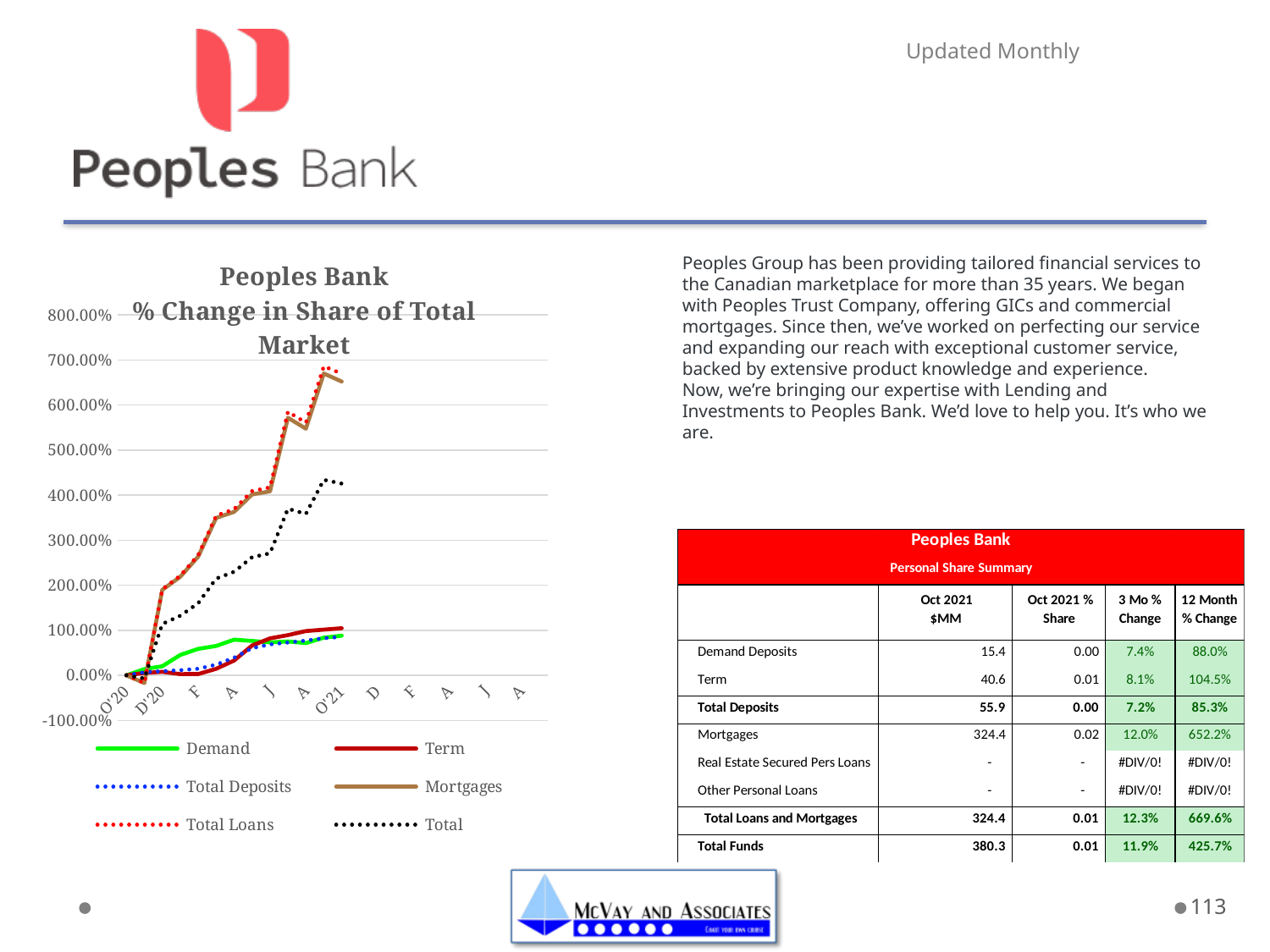
What kind of chart is shown on the slide? line chart Is the value of the Mortgages series at O'21 greater or less than 600.00%? greater Does the Mortgages series generally rise or fall from O'20 to O'21? rise At O'21, which series has the higher value, Mortgages or Total? Mortgages Is the value of the Demand series at O'21 greater or less than 200.00%? less At O'21, which series has the higher value, Total or Demand? Total Does the Total series generally rise or fall from O'20 to O'21? rise Is the value of the Total series at O'21 greater or less than 300.00%? greater What is the title of the chart? Peoples Bank % Change in Share of Total Market Which series is drawn as a solid green line in the chart? Demand How many series does the chart legend list? 6